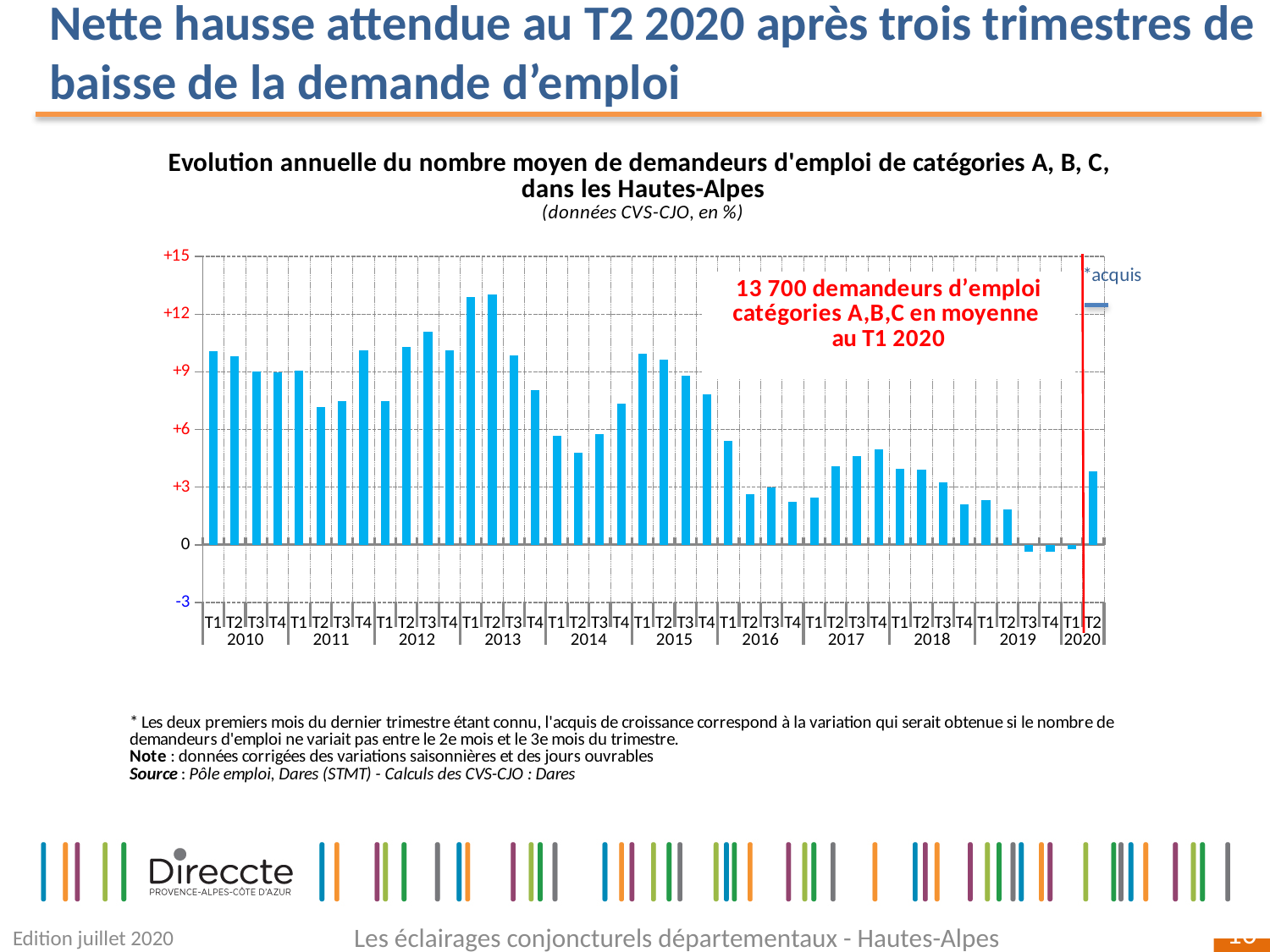
What kind of chart is shown on the slide? bar chart In what unit are the chart's data expressed, according to the subtitle? en % According to the annotation on the chart, how many demandeurs d'emploi catégories A,B,C were there on average in T1 2020? 13 700 Which is larger, the value for T3 2019 or the value for T2 2020? T2 2020 How many quarterly bars are plotted in the chart, from T1 2010 to T2 2020? 42 Is the value for T2 2020 greater or less than +3? greater Is the value for T2 2013 greater or less than +12? greater Is the value for T4 2019 greater or less than 0? less Which is larger, the value for T2 2013 or the value for T2 2016? T2 2013 Do the values generally rise or fall from T1 2017 to T4 2019? fall